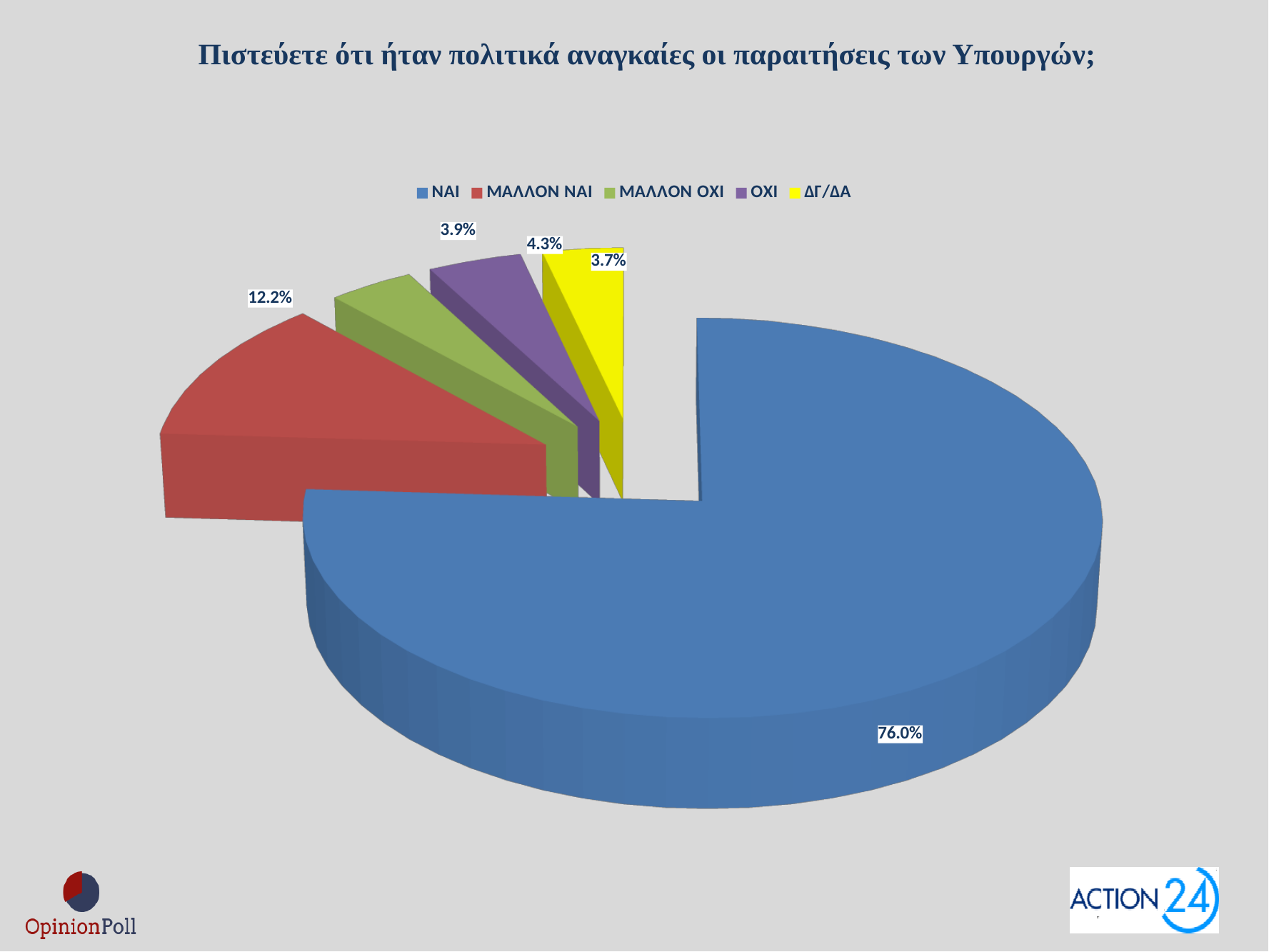
What is the value for ΜΑΛΛΟΝ ΝΑΙ? 12.2% What is the value for ΔΓ/ΔΑ? 3.7% Which category has the largest share of the pie? ΝΑΙ What is the value for ΟΧΙ? 4.3% Which is larger, the value for ΟΧΙ or the value for ΜΑΛΛΟΝ ΟΧΙ? ΟΧΙ How many categories does the legend list? 5 What kind of chart is shown on the slide? pie chart Which category has the smallest share of the pie? ΔΓ/ΔΑ What is the value for ΜΑΛΛΟΝ ΟΧΙ? 3.9% What is the value for ΝΑΙ? 76.0% What is the difference between the values for ΝΑΙ and ΜΑΛΛΟΝ ΝΑΙ? 63.8% What colour is the slice for ΔΓ/ΔΑ? yellow